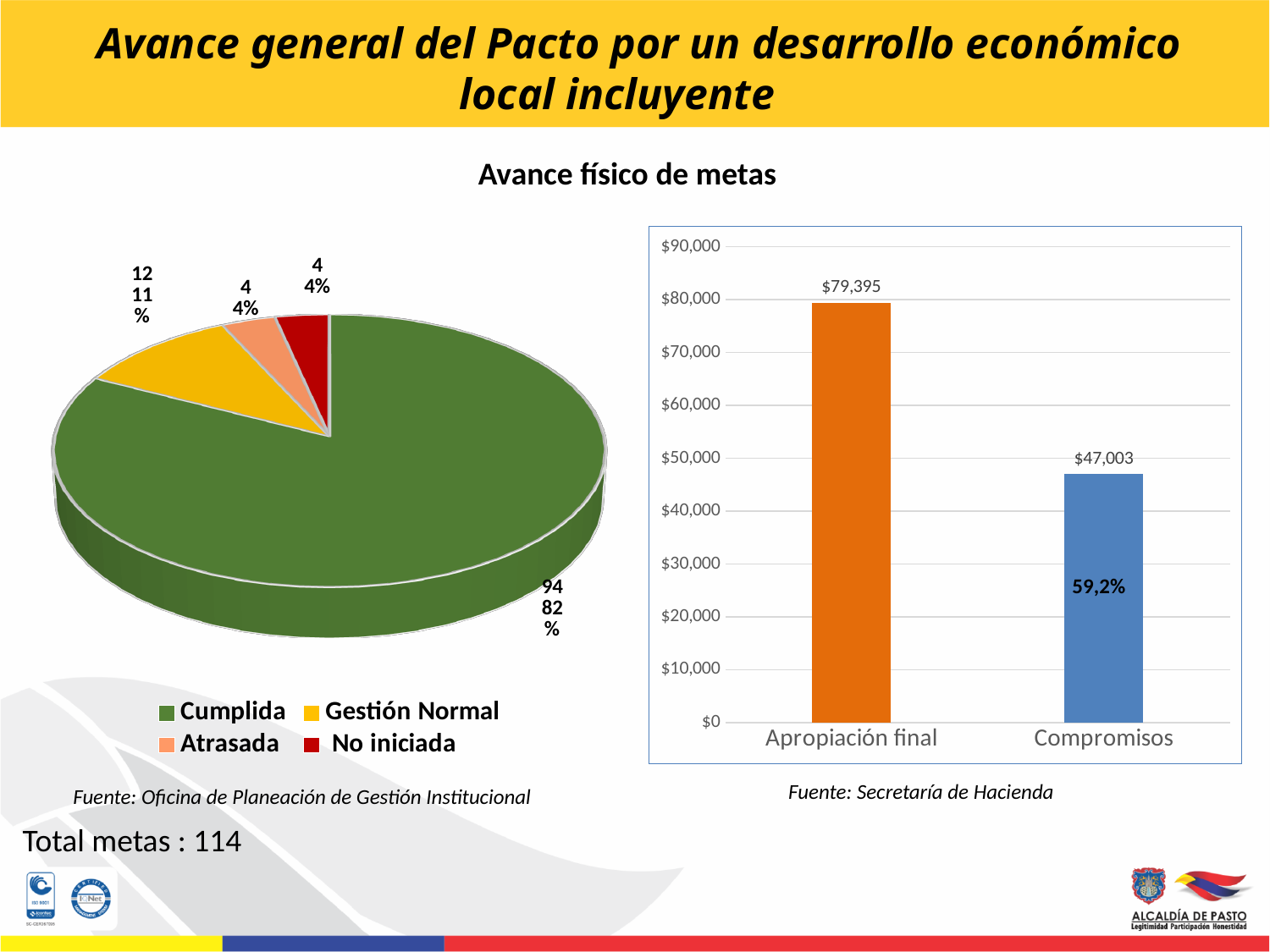
On the pie chart on the left, which category has the largest slice? Cumplida On the pie chart on the left, which colour represents No iniciada? Red On the pie chart on the left, what percentage share does Atrasada have? 4% On the pie chart on the left, how many metas are in the Gestión Normal category? 12 On the pie chart on the left, what percentage of the metas are Cumplida? 82% What kind of chart is shown on the right side of the slide? Bar chart On the bar chart on the right, which category has the higher value, Apropiación final or Compromisos? Apropiación final On the bar chart on the right, what is the value for Compromisos? $47,003 On the pie chart on the left, how many categories does the legend list? 4 On the bar chart on the right, what is the value for Apropiación final? $79,395 On the bar chart on the right, what is the difference between Apropiación final and Compromisos? $32,392 On the pie chart on the left, what is the difference in count between Cumplida and Gestión Normal? 82